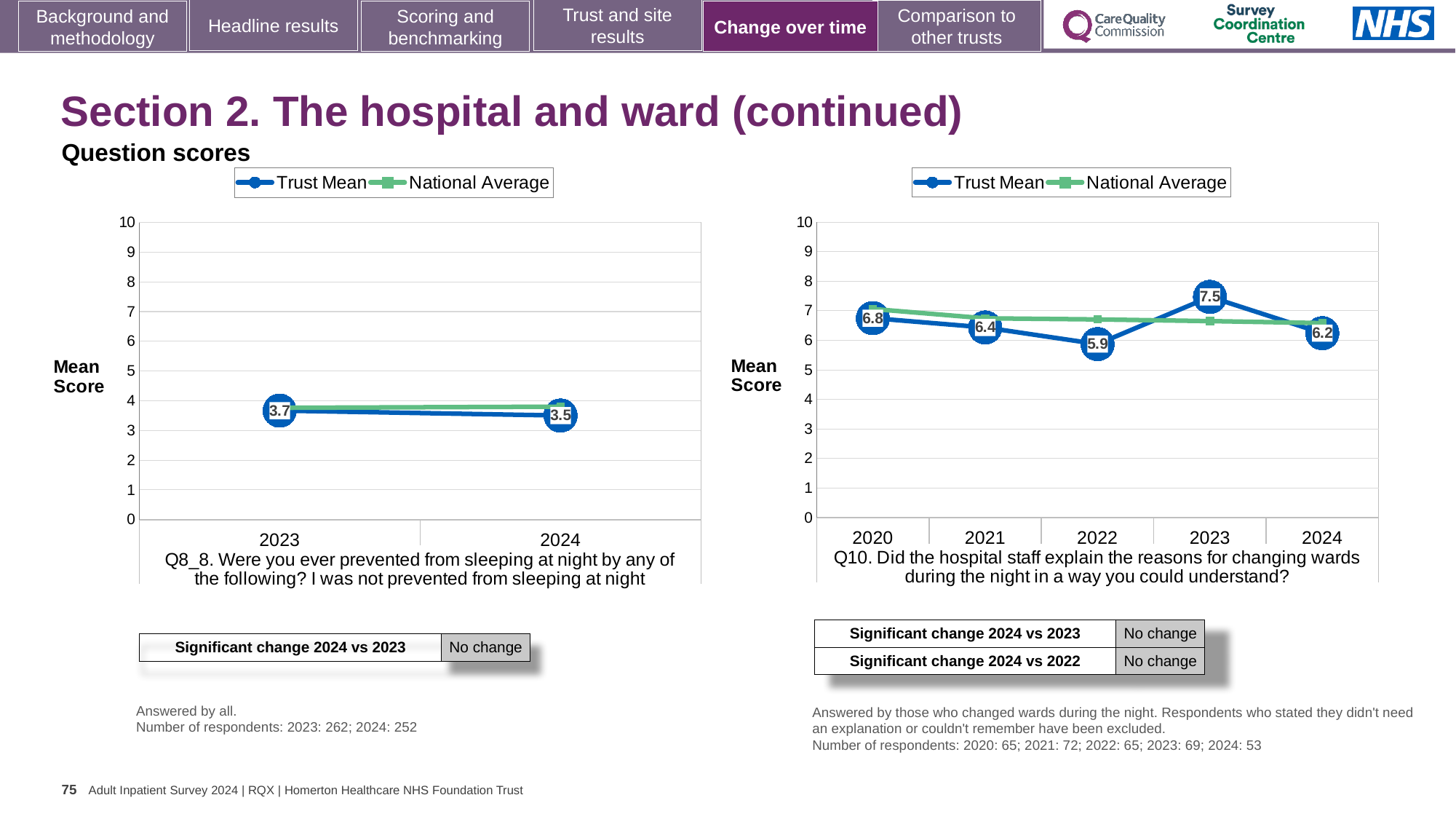
In the Q8_8 chart on the left, what is the Trust Mean score for 2023? 3.7 In the Q10 chart on the right, which year has the lowest Trust Mean score? 2022 In the Q10 chart on the right, which year has the highest Trust Mean score? 2023 In the Q10 chart on the right, is the Trust Mean score for 2020 or 2021 larger? 2020 In the Q8_8 chart on the left, does the Trust Mean rise or fall from 2023 to 2024? fall In the Q8_8 chart on the left, what is the Trust Mean score for 2024? 3.5 How many series does the legend of the Q8_8 chart on the left list? 2 In the Q10 chart on the right, what is the Trust Mean score for 2022? 5.9 In the Q8_8 chart on the left, by how much did the Trust Mean change from 2023 to 2024? 0.2 In the Q10 chart on the right, what is the difference between the Trust Mean scores for 2023 and 2024? 1.3 How many years are plotted on the x axis of the Q10 chart on the right? 5 In the Q10 chart on the right, what is the Trust Mean score for 2023? 7.5